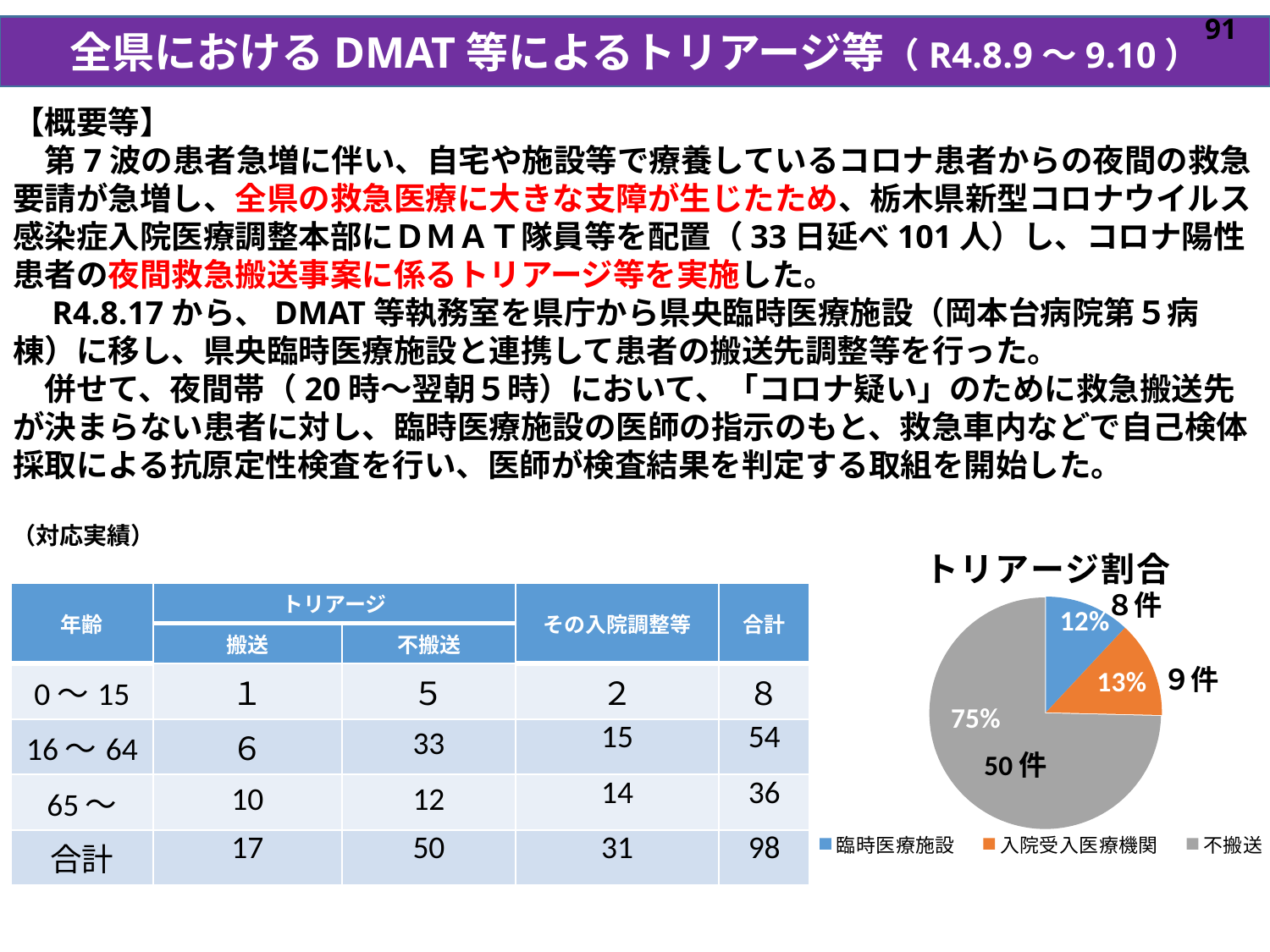
Which category has the largest slice in the pie chart? 不搬送 How many entries does the legend of the pie chart list? 3 What is the title of the pie chart? トリアージ割合 How many cases (件) are shown for 入院受入医療機関 in the pie chart? 9件 Which category has the smallest slice in the pie chart? 臨時医療施設 What percentage share does 不搬送 have in the pie chart? 75% What is the difference in cases between 不搬送 and 入院受入医療機関 in the pie chart? 41件 What kind of chart is shown on the slide? pie chart What percentage share does 入院受入医療機関 have in the pie chart? 13% What percentage share does 臨時医療施設 have in the pie chart? 12% How many cases (件) are shown for 不搬送 in the pie chart? 50件 How many cases (件) are shown for 臨時医療施設 in the pie chart? 8件